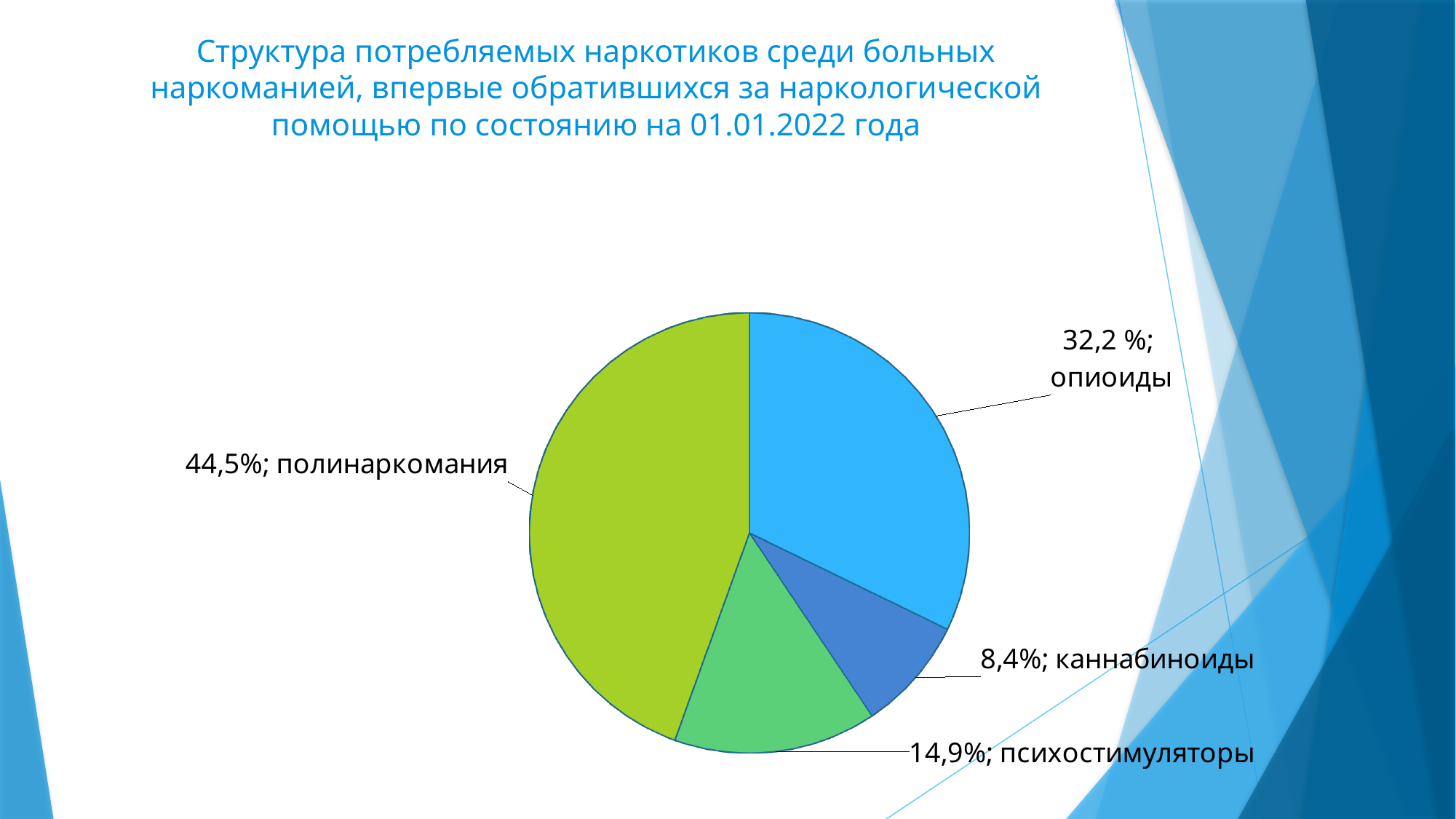
What is the difference in percentage points between психостимуляторы and каннабиноиды? 6,5 Which category has the largest slice of the pie? полинаркомания What share of the pie is labelled опиоиды? 32,2 % What share of the pie is labelled каннабиноиды? 8,4% What share of the pie is labelled полинаркомания? 44,5% Which is larger, the share for психостимуляторы or the share for каннабиноиды? психостимуляторы What share of the pie is labelled психостимуляторы? 14,9% What is the difference in percentage points between полинаркомания and опиоиды? 12,3 What kind of chart is shown on the slide? pie chart What colour is the slice for полинаркомания? green (yellow-green) How many slices does the pie chart have? 4 Which category has the smallest slice of the pie? каннабиноиды